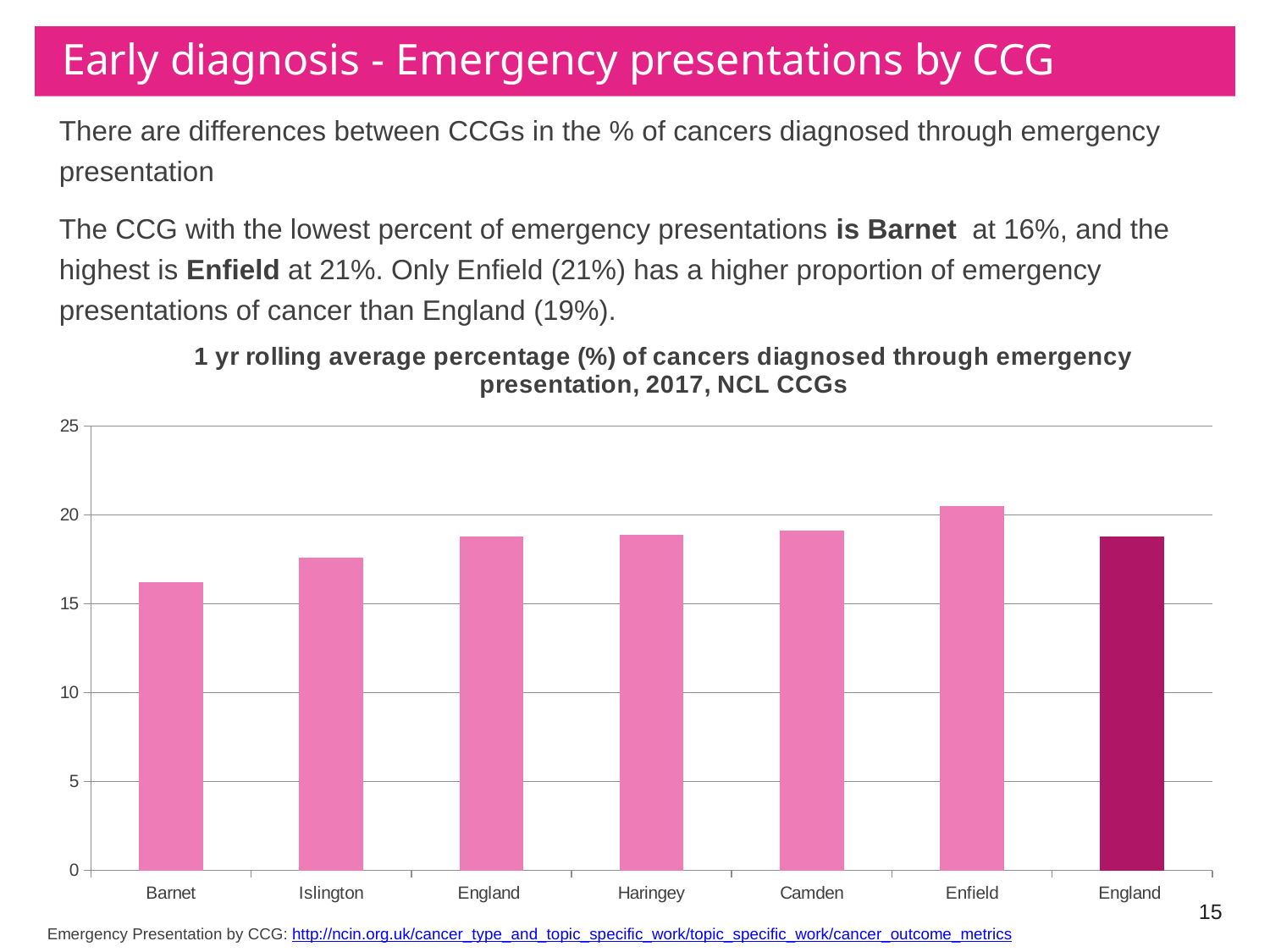
Is the value for Enfield greater or less than 20? greater Is the value for Camden greater or less than 20? less What is the title of the chart? 1 yr rolling average percentage (%) of cancers diagnosed through emergency presentation, 2017, NCL CCGs Which has the larger value, Camden or Islington? Camden Which has the larger value, Enfield or Barnet? Enfield Do the bars rise or fall from Barnet across to Enfield? rise How many bars are plotted in the chart? 7 Which category has the lowest bar in the chart? Barnet Is the value for Islington greater or less than 20? less Which category has the highest bar in the chart? Enfield What kind of chart is shown on the slide? Bar chart